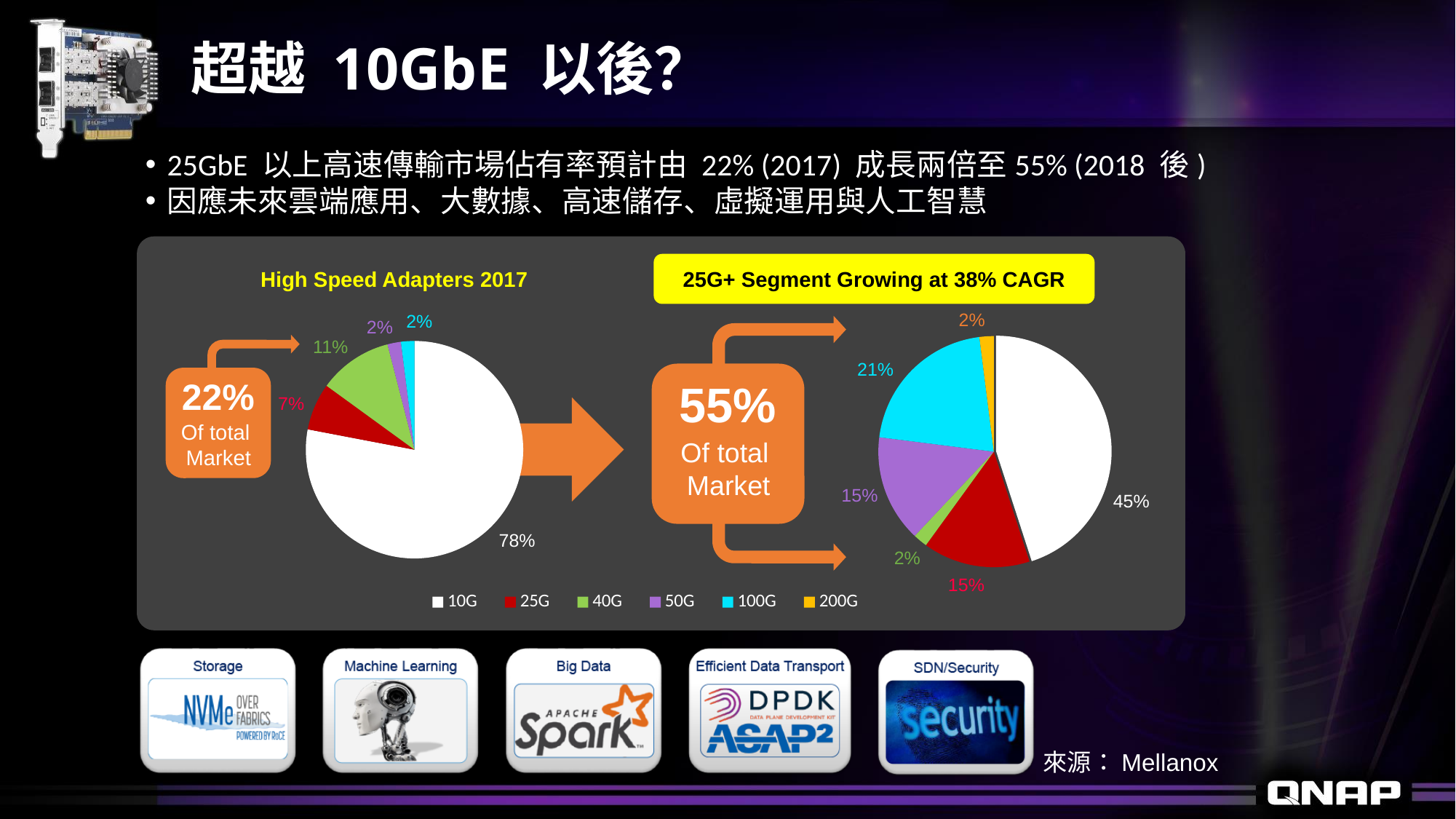
In the right-hand pie chart (25G+ Segment Growing at 38% CAGR), which category has the largest slice? 10G In the right-hand pie chart (25G+ Segment Growing at 38% CAGR), what share does 10G hold? 45% In the 'High Speed Adapters 2017' pie chart on the left, what share does 10G hold? 78% In the right-hand pie chart (25G+ Segment Growing at 38% CAGR), what share does 200G hold? 2% In the 'High Speed Adapters 2017' pie chart on the left, which category has the largest slice? 10G How many categories does the shared legend below the pie charts list? 6 In the 'High Speed Adapters 2017' pie chart on the left, what share does 40G hold? 11% What type of chart is used to show the High Speed Adapters market shares on this slide? pie chart In the right-hand pie chart, is the 100G slice larger or smaller than the 25G slice? larger In the 'High Speed Adapters 2017' pie chart on the left, what share does 25G hold? 7% In the right-hand pie chart (25G+ Segment Growing at 38% CAGR), what share does 100G hold? 21% What is the difference between the 10G share in the left pie chart (78%) and the 10G share in the right pie chart (45%)? 33%